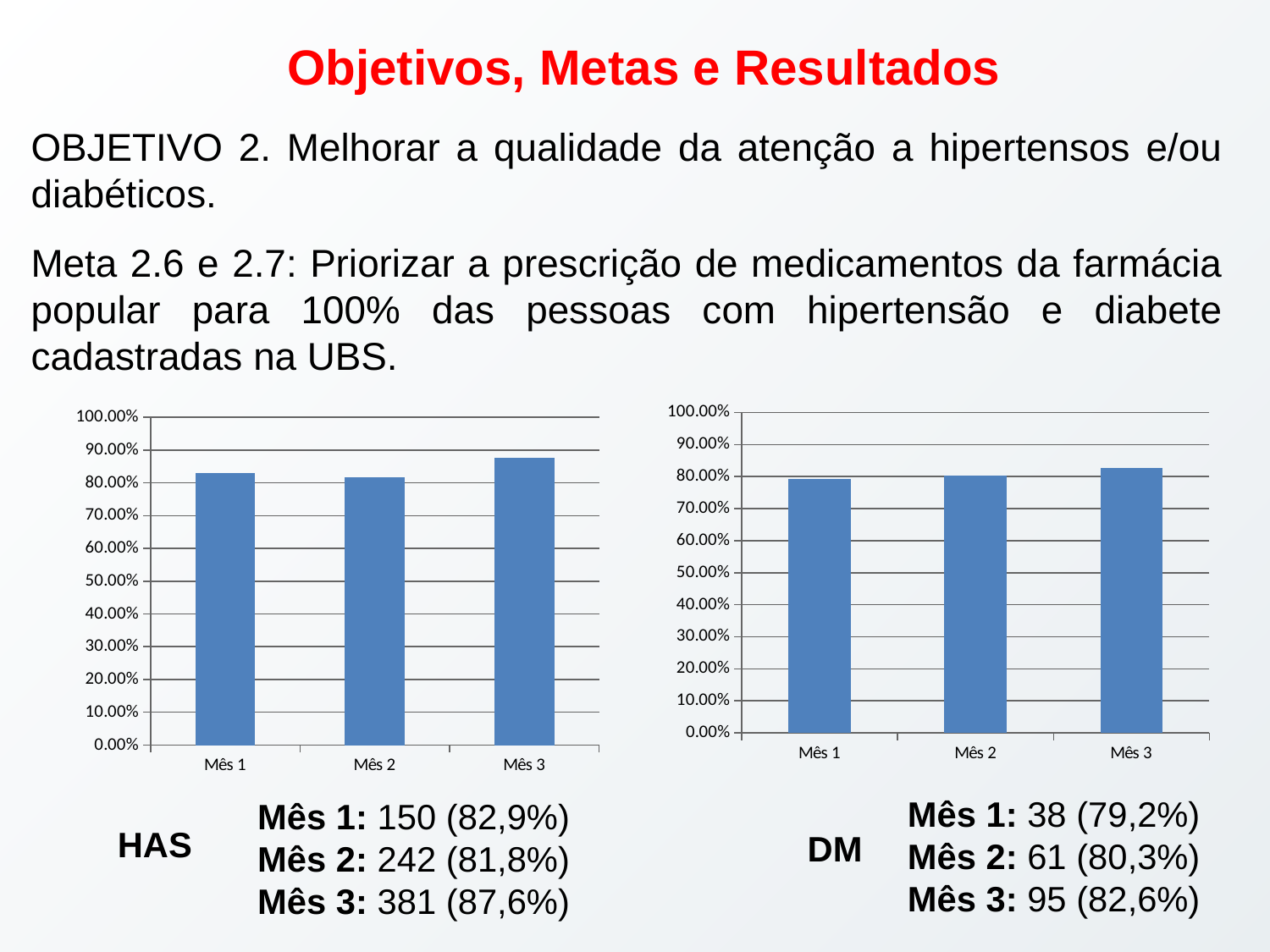
On the DM chart (right), what is the value for Mês 3? 82,6% On the DM chart (right), what is the value for Mês 1? 79,2% On the HAS chart (left), is the value for Mês 3 greater or less than 80.00%? greater How many months are plotted on the DM chart (right)? 3 On the DM chart (right), do the values rise or fall from Mês 1 to Mês 3? rise On the HAS chart (left), what is the value for Mês 3? 87,6% On the DM chart (right), which month has the highest value? Mês 3 What kind of chart is the HAS chart (left)? bar chart On the HAS chart (left), which month has the highest value? Mês 3 On the HAS chart (left), what is the value for Mês 2? 81,8% On the DM chart (right), what is the difference between the values for Mês 3 and Mês 1? 3,4 percentage points On the HAS chart (left), what is the difference between the values for Mês 3 and Mês 1? 4,7 percentage points